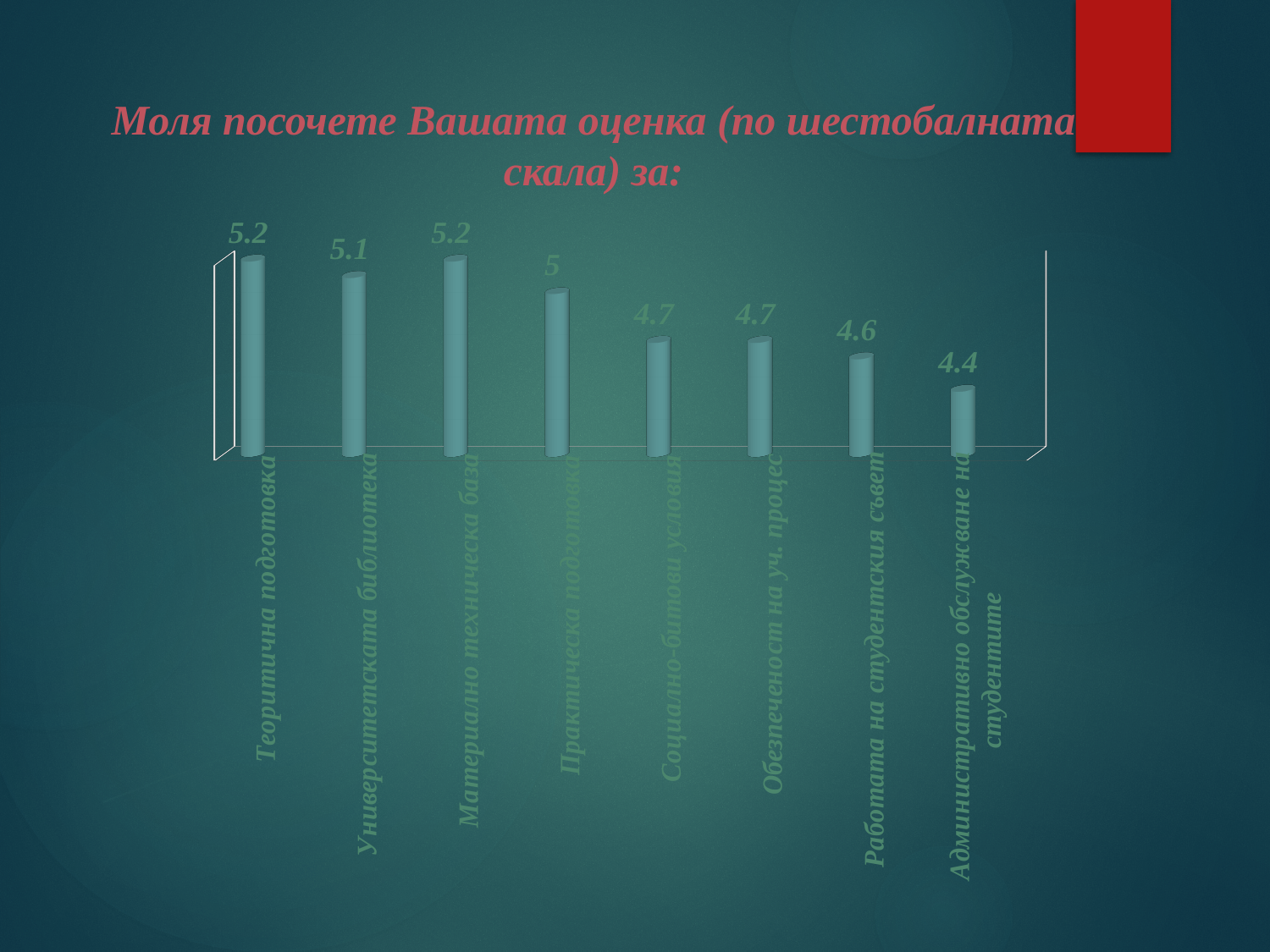
What kind of chart is shown on the slide? Bar chart What is the difference between the values for Теоритична подготовка and Административно обслужване на студентите? 0.8 What is the value for Университетската библиотека? 5.1 Do the values generally rise or fall from left to right across the categories? Fall What is the value for Социално-битови условия? 4.7 Which category has the lowest value? Административно обслужване на студентите What is the value for Работата на студентския съвет? 4.6 How many categories are shown in the chart? 8 What is the value for Практическа подготовка? 5 Which is larger, the value for Практическа подготовка or the value for Обезпеченост на уч. процес? Практическа подготовка Which is larger, the value for Материално техническа база or the value for Университетската библиотека? Материално техническа база What is the difference between the values for Университетската библиотека and Работата на студентския съвет? 0.5